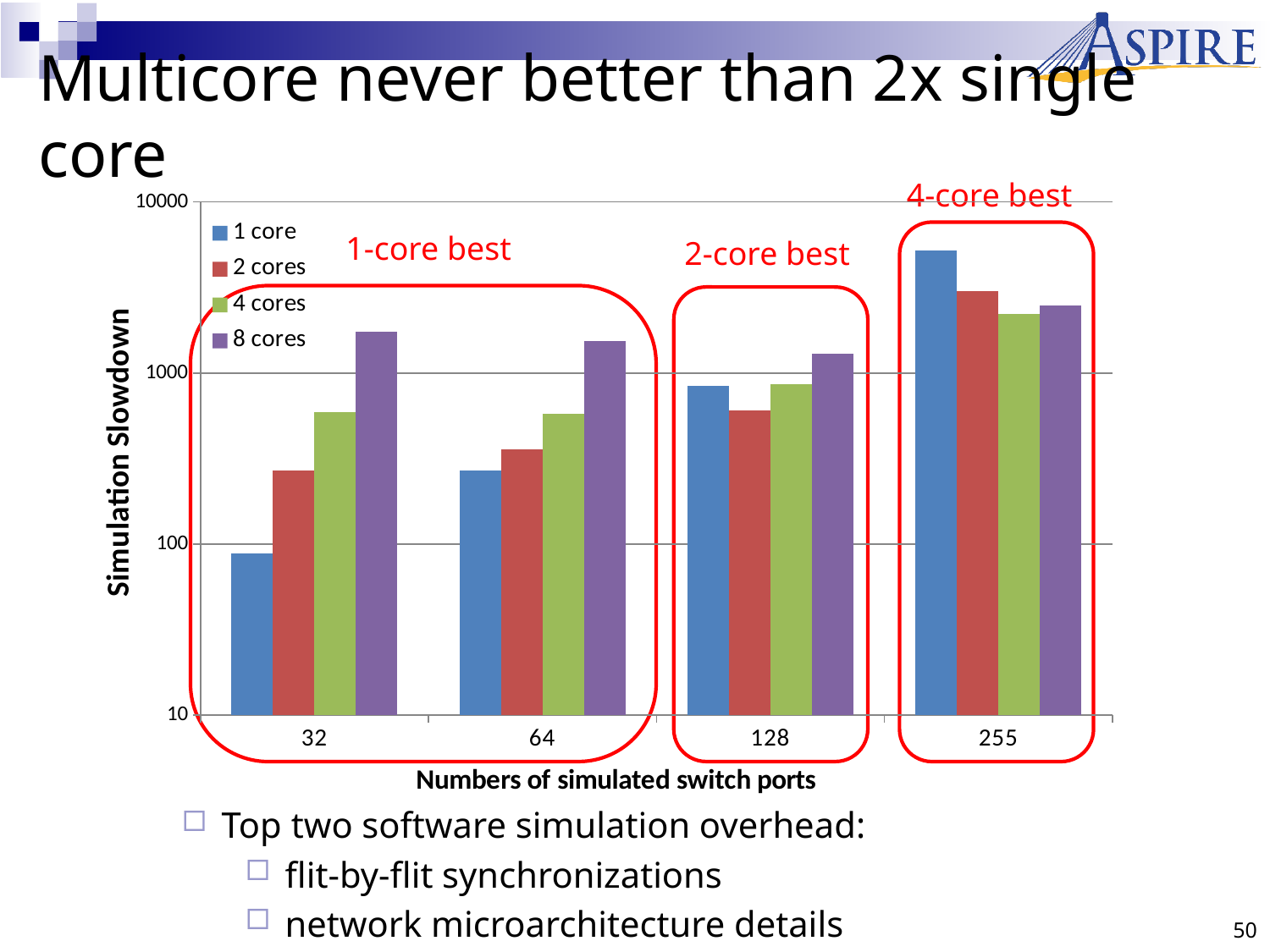
How many series does the legend list? 4 Which series has the lowest simulation slowdown at 128 switch ports? 2 cores Is the value for 1 core at 128 switch ports greater or less than 1000? less Is the value for 1 core at 32 switch ports greater or less than 100? less Is the value for 8 cores at 32 switch ports greater or less than 1000? greater Does the simulation slowdown for 1 core rise or fall as the number of switch ports increases? rise Which series has the highest simulation slowdown at 32 switch ports? 8 cores What kind of chart is shown on the slide? bar chart Which series has the highest simulation slowdown at 255 switch ports? 1 core What is the title of the y axis? Simulation Slowdown How many categories of simulated switch ports are shown on the x axis? 4